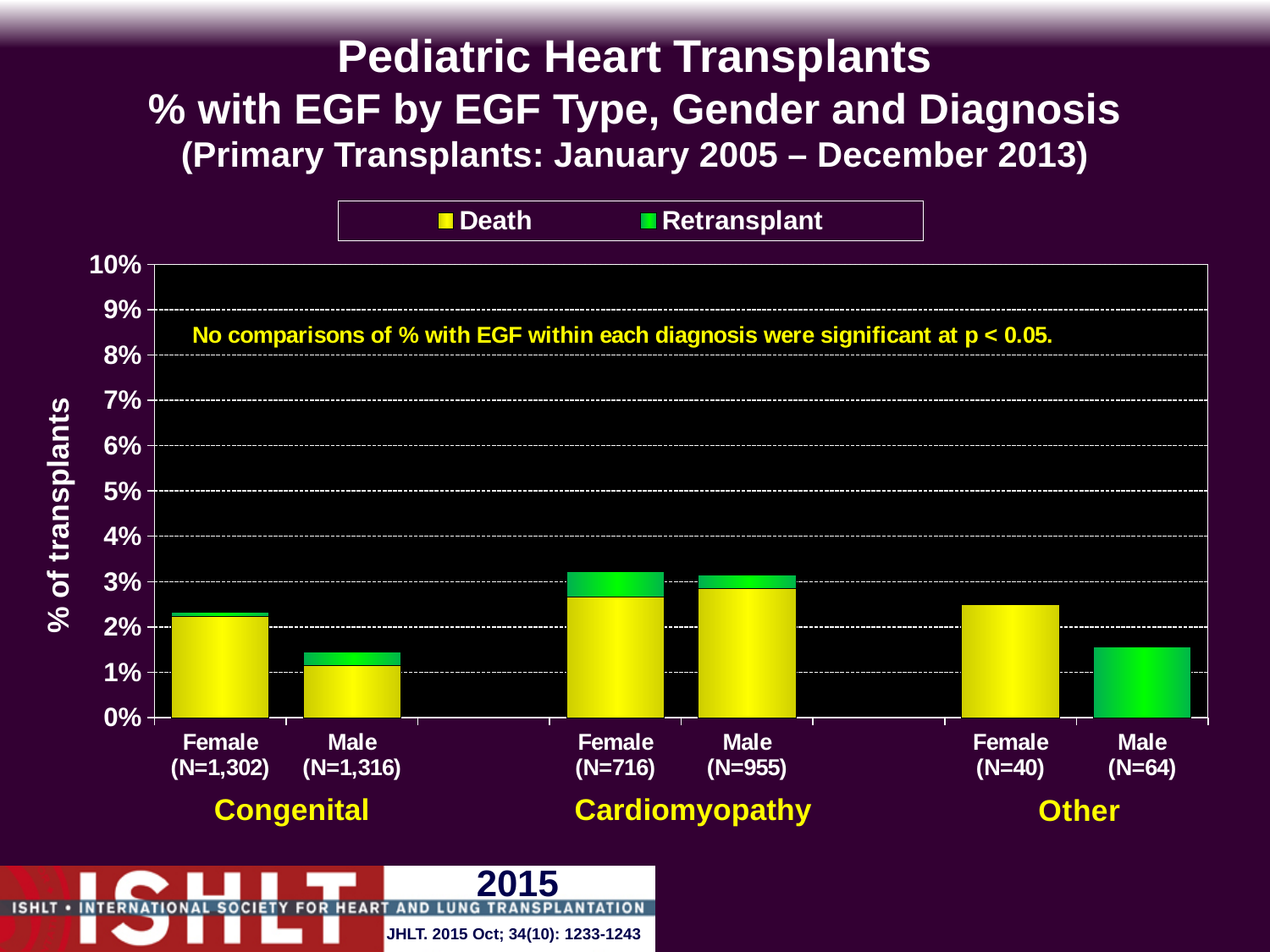
Is the total value for Other Male greater or less than 2%? less Is the total value for Other Female greater or less than 3%? less Is the total value for Cardiomyopathy Female greater or less than 3%? greater What is the label of the y axis? % of transplants Which two series are listed in the legend? Death and Retransplant Which has the larger total % with EGF, Other Female or Other Male? Other Female What kind of chart is shown on the slide? bar chart Which has the larger total % with EGF, Congenital Female or Congenital Male? Congenital Female How many series does the legend list? 2 How many bars are plotted in the chart? 6